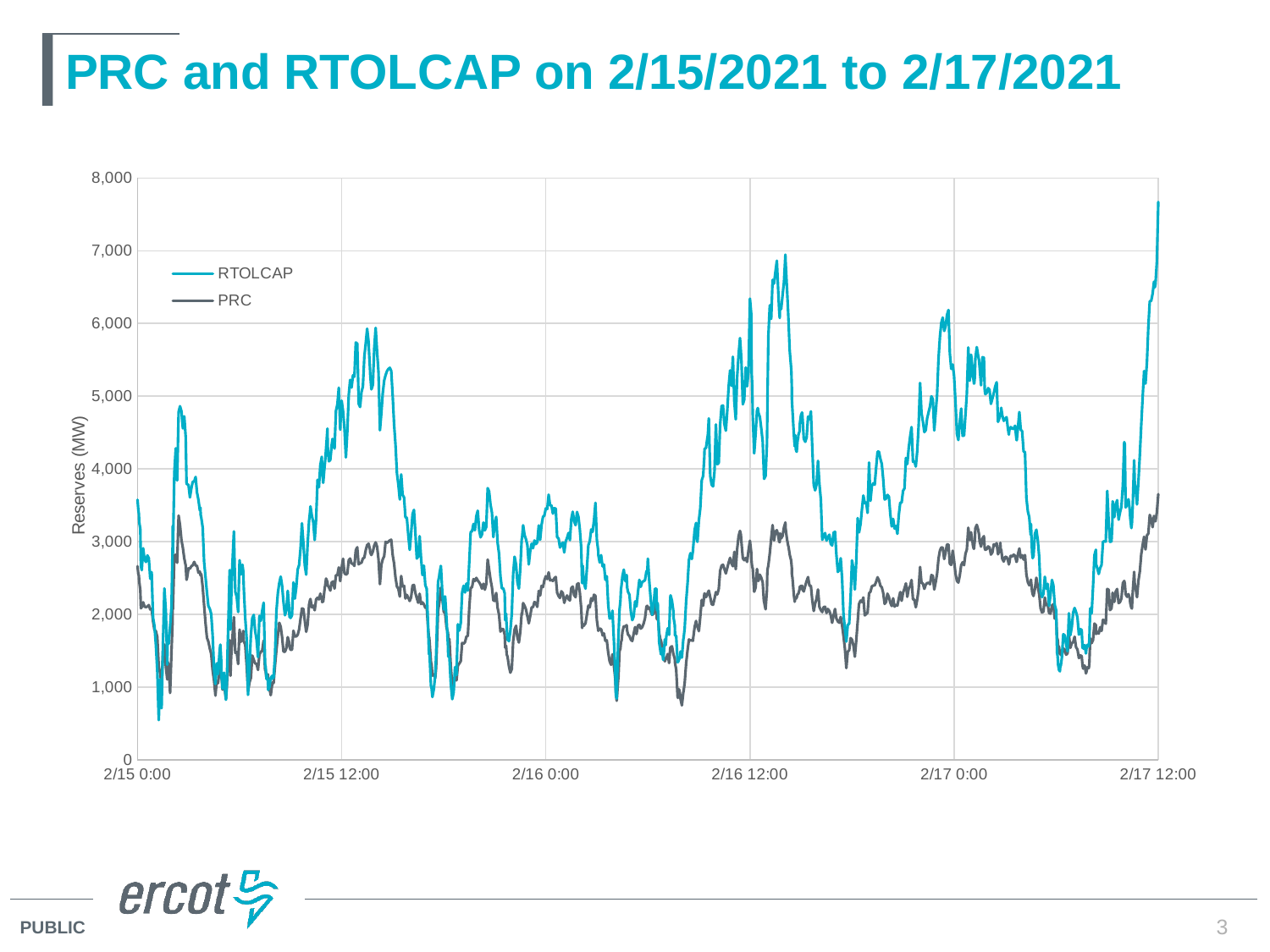
Is the RTOLCAP value at the end of the chart (2/17 12:00) greater or less than 7,000? greater Is the RTOLCAP value at 2/15 0:00 greater or less than 3,000? greater Which series is plotted higher across the whole period, RTOLCAP or PRC? RTOLCAP At 2/16 12:00, which series has the higher value, RTOLCAP or PRC? RTOLCAP What is the label of the vertical axis? Reserves (MW) Is the PRC value at 2/15 0:00 greater or less than 2,000? greater How many series does the legend list? 2 What kind of chart is shown on the slide? Line chart What are the two series named in the legend? RTOLCAP and PRC How many time labels are shown along the x axis? 6 Do the RTOLCAP values rise or fall over the final hours before 2/17 12:00? rise